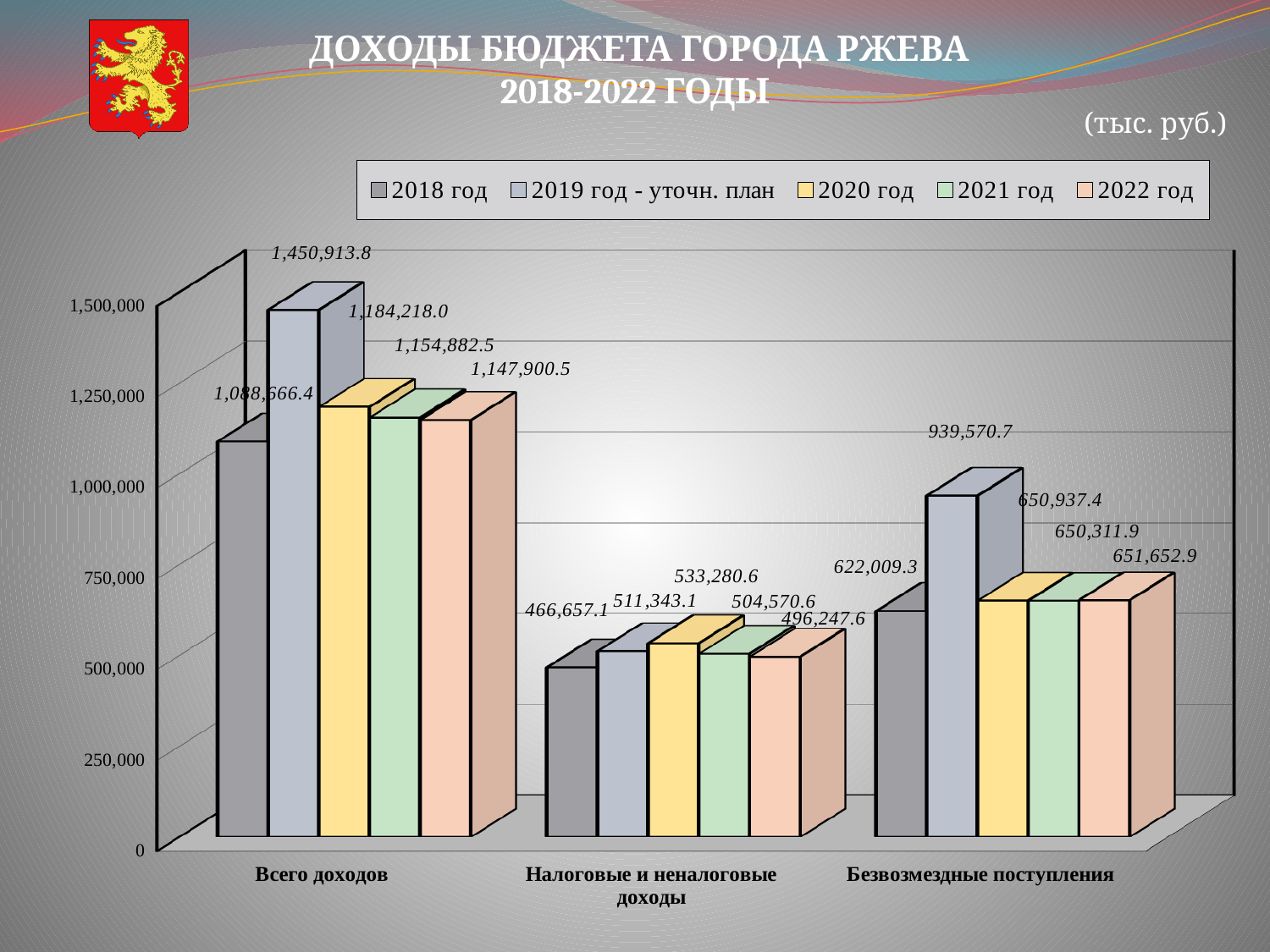
In the Налоговые и неналоговые доходы category, which is larger: the 2020 год value or the 2022 год value? 2020 год What is the value for 2018 год in the Безвозмездные поступления category? 622,009.3 How many series does the legend list? 5 What is the difference between the 2019 год - уточн. план and 2020 год values in the Всего доходов category? 266,695.8 What kind of chart is shown on the slide? Bar chart Which year has the lowest value in the Налоговые и неналоговые доходы category? 2018 год What is the value for 2020 год in the Налоговые и неналоговые доходы category? 533,280.6 What is the value for 2019 год - уточн. план in the Всего доходов category? 1,450,913.8 How many categories are shown on the x axis? 3 What is the difference between the 2019 год - уточн. план and 2018 год values in the Безвозмездные поступления category? 317,561.4 Which year has the highest value in the Безвозмездные поступления category? 2019 год - уточн. план What is the value for 2022 год in the Всего доходов category? 1,147,900.5